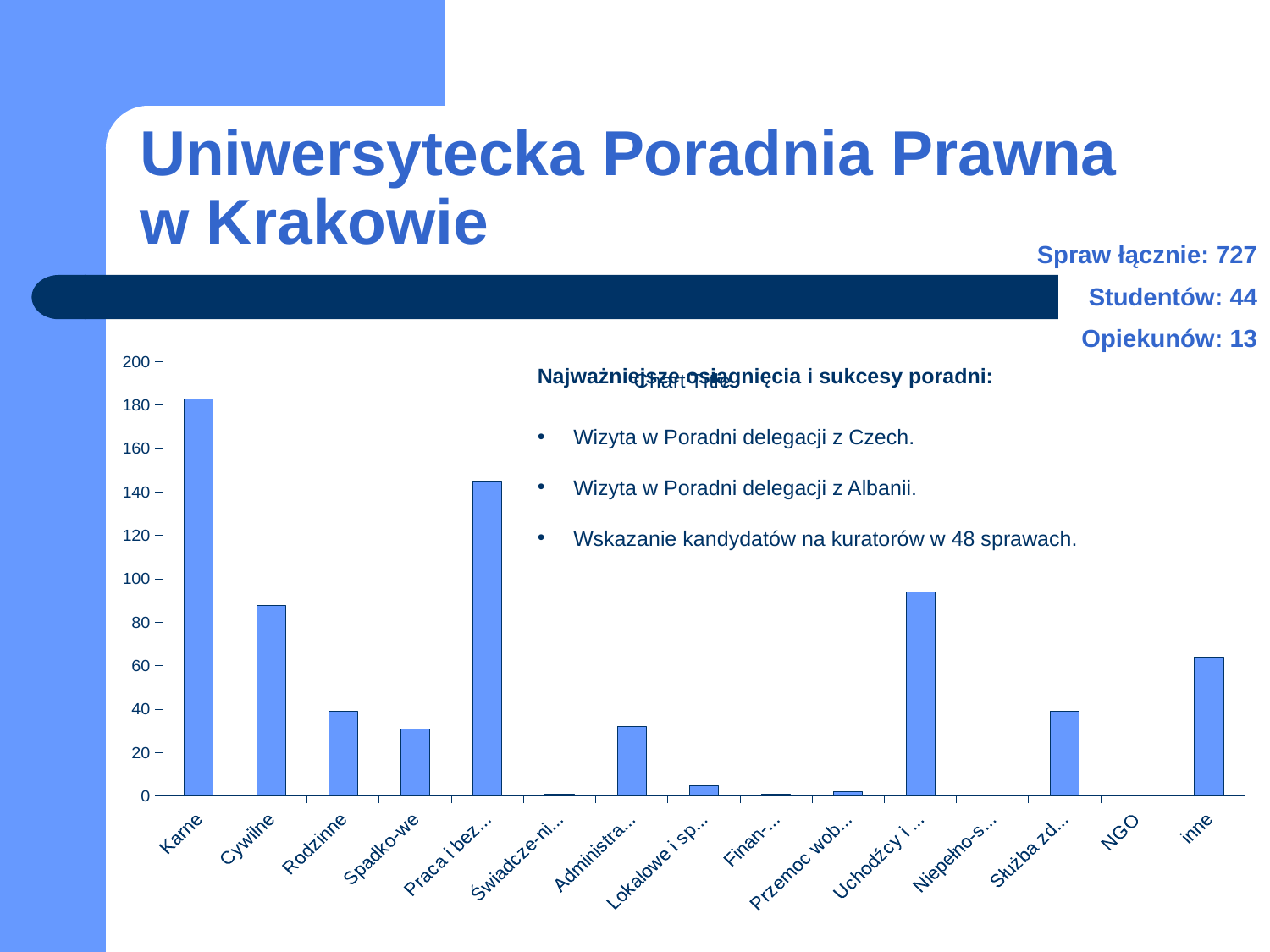
Is the value for inne greater or less than 80? less Is the value for Karne greater or less than 160? greater How many categories are shown on the x axis of the chart? 15 Which is larger, the value for Uchodźcy i ... or the value for inne? Uchodźcy i ... Is the value for Spadko-we greater or less than 20? greater Which is larger, the value for Karne or the value for Praca i bez...? Karne What kind of chart is shown on the slide? bar chart Which category has the highest bar in the chart? Karne What is the highest tick value shown on the vertical axis of the chart? 200